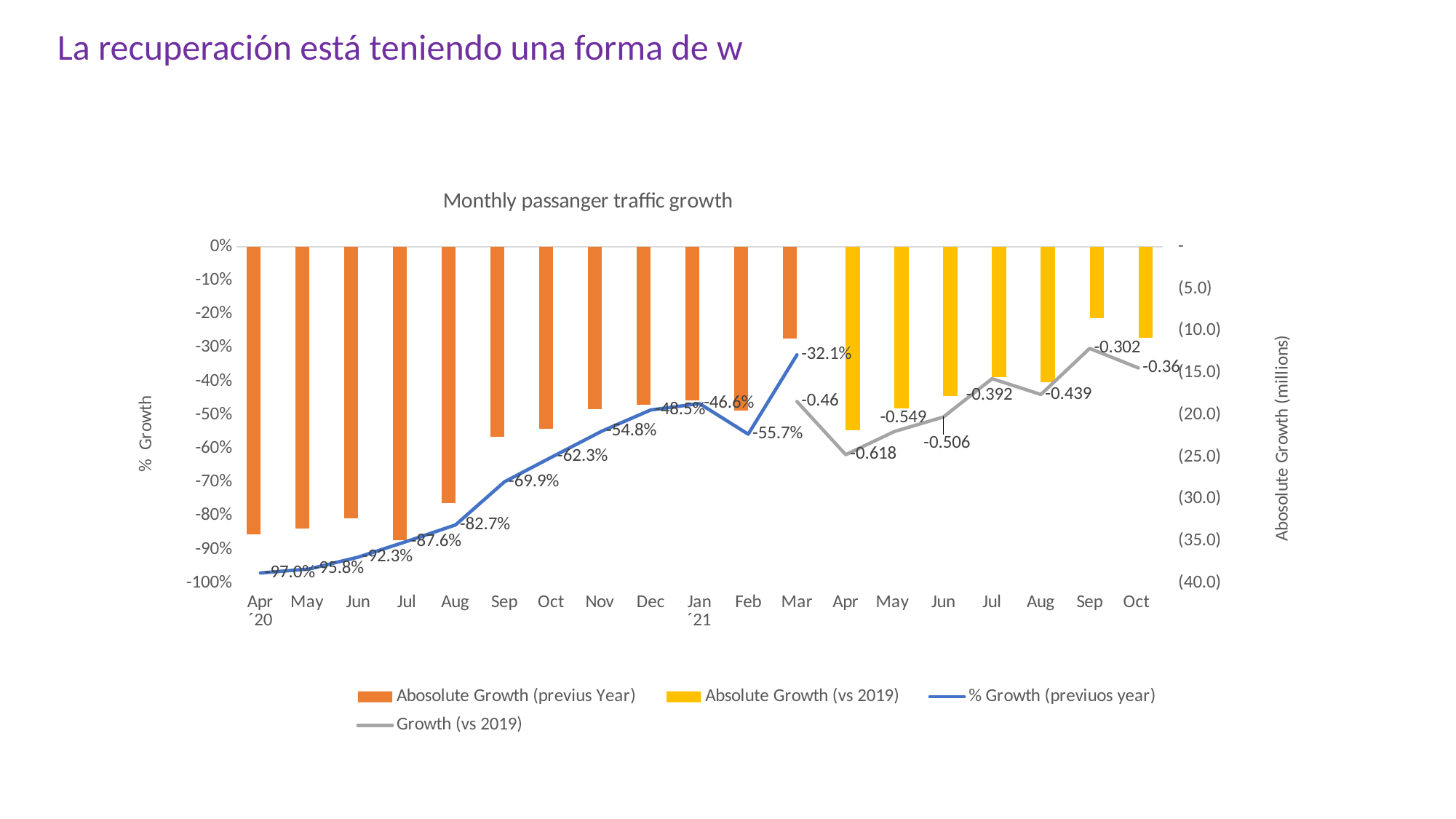
What kind of chart is this? Combined bar and line chart In which month does the % Growth (previous year) line reach its highest value? Mar '21 Does the % Growth (previous year) line rise or fall from Apr '20 to Jan '21? Rise In which month does the Growth (vs 2019) line reach its lowest value? Apr '21 What is the % Growth (previous year) value for Apr '20? -97.0% What is the % Growth (previous year) value for Mar '21? -32.1% By how many percentage points does the % Growth (previous year) value change from Feb '21 (-55.7%) to Mar '21 (-32.1%)? 23.6 percentage points How many series does the legend list? 4 What is the Growth (vs 2019) value for Sep '21? -0.302 What is the Growth (vs 2019) value for Apr '21? -0.618 Which month has the higher % Growth (previous year) value, Jan '21 or Feb '21? Jan '21 How many months are shown on the x axis of the chart? 19